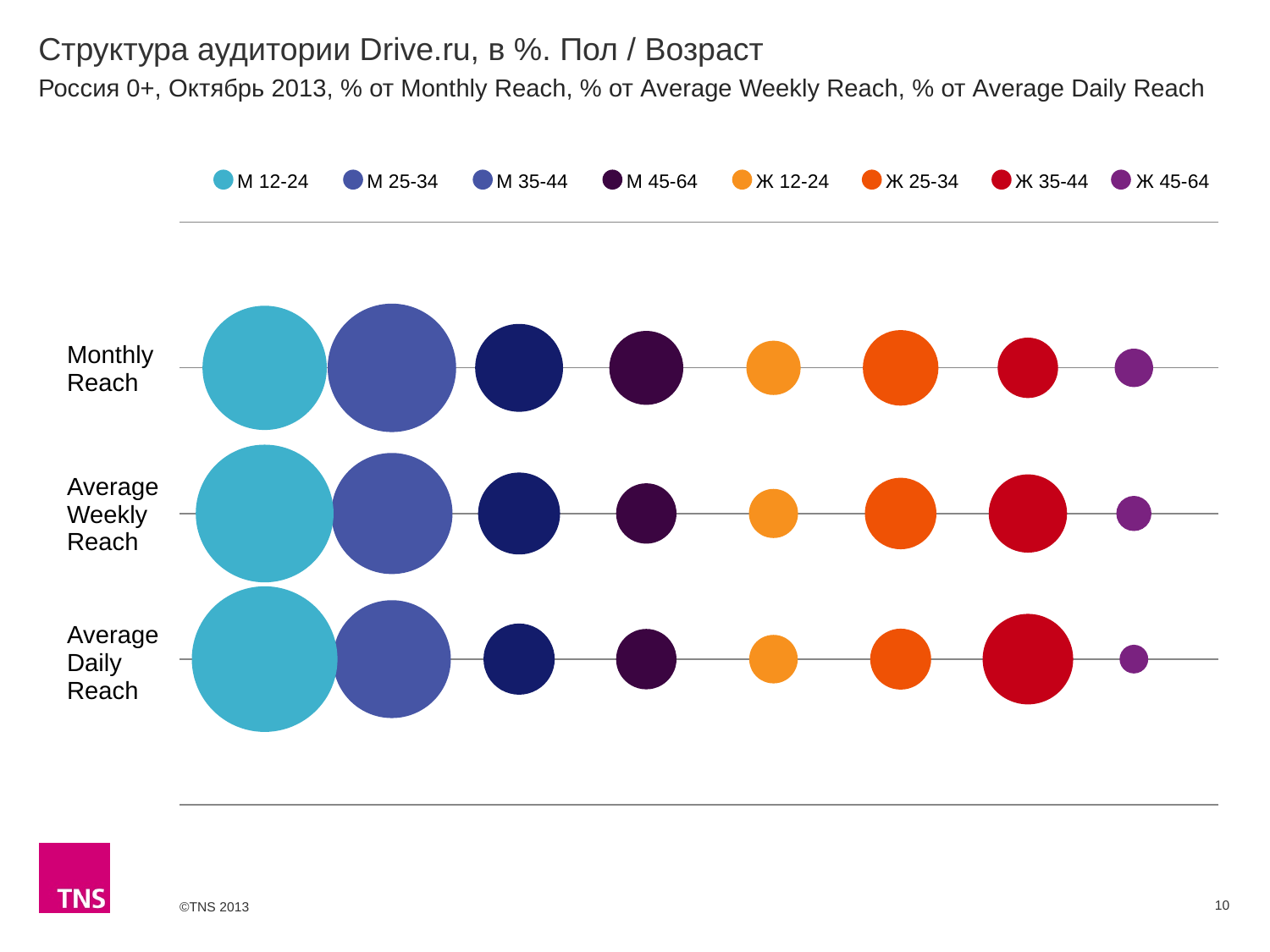
In the Average Weekly Reach row, which bubble is larger: М 35-44 or Ж 45-64? М 35-44 Which series has the smallest bubble in the Monthly Reach row? Ж 45-64 Which series has the largest bubble in the Average Daily Reach row? М 12-24 What is the title of the chart on the slide? Структура аудитории Drive.ru, в %. Пол / Возраст Does the Ж 35-44 bubble get larger or smaller going from Monthly Reach to Average Daily Reach? Larger In the Monthly Reach row, which bubble is larger: Ж 25-34 or Ж 12-24? Ж 25-34 In the Average Daily Reach row, which bubble is larger: Ж 35-44 or Ж 12-24? Ж 35-44 What kind of chart is shown on the slide? Bubble chart How many reach categories (rows) are plotted on the chart? 3 Which series has the smallest bubble in the Average Daily Reach row? Ж 45-64 How many series does the legend list? 8